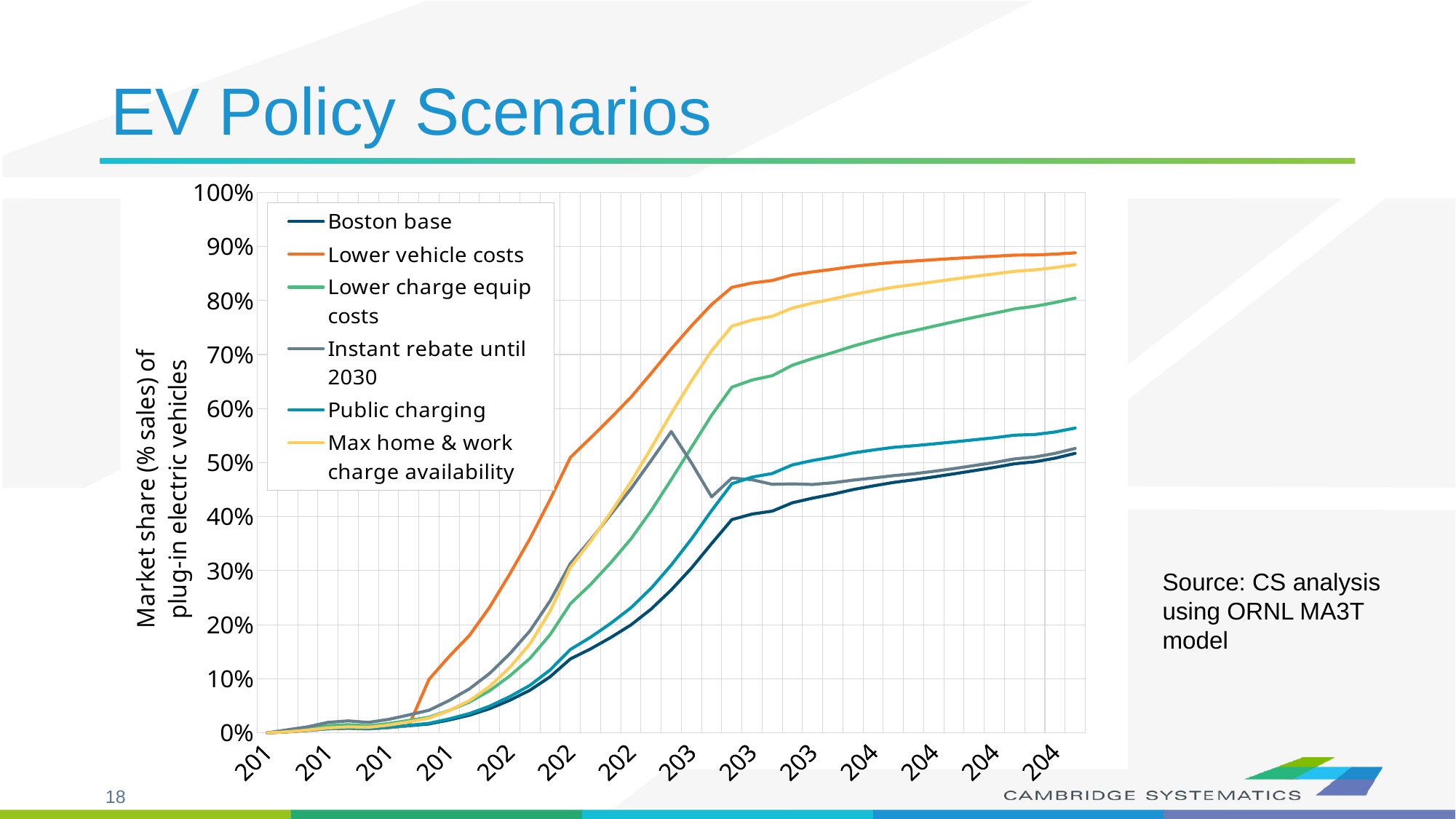
At the right end of the chart, is the value for Public charging greater or less than 60%? less At the right end of the chart, is the value for Lower charge equip costs greater or less than 70%? greater Which series has the lowest market share at the right end of the chart? Boston base At the right end of the chart, which is larger: Max home & work charge availability or Lower charge equip costs? Max home & work charge availability Does the Boston base series generally rise or fall from left to right? rise What is the label on the vertical axis of the chart? Market share (% sales) of plug-in electric vehicles Which series shows a sharp drop after peaking in the middle of the chart? Instant rebate until 2030 What kind of chart is shown on the slide? line chart At the right end of the chart, is the value for Lower vehicle costs greater or less than 80%? greater Which series has the highest market share at the right end of the chart? Lower vehicle costs How many series does the legend list? 6